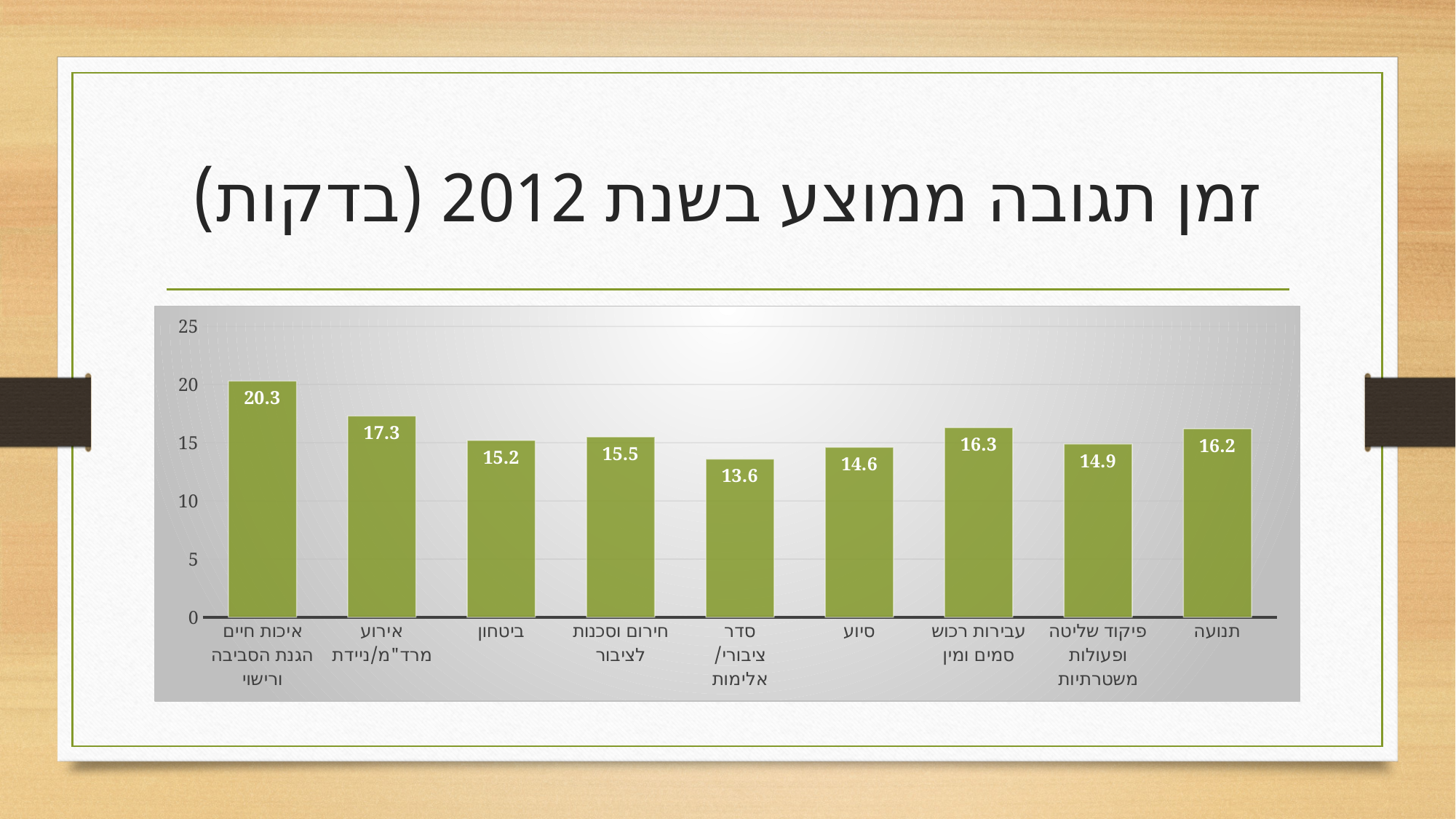
Is the value for פיקוד שליטה ופעולות משטרתיות greater or less than 15? less How many categories are shown in the chart? 9 What is the value for ביטחון? 15.2 What is the difference between the values for איכות חיים הגנת הסביבה ורישוי and סדר ציבורי/אלימות? 6.7 What is the difference between the values for עבירות רכוש סמים ומין and סיוע? 1.7 Which category has the lowest value? סדר ציבורי/אלימות Which is larger, the value for אירוע מרד"מ/ניידת or the value for חירום וסכנות לציבור? אירוע מרד"מ/ניידת What is the value for תנועה? 16.2 What is the title of the chart on the slide? זמן תגובה ממוצע בשנת 2012 (בדקות) What is the value for סיוע? 14.6 Which category has the highest value? איכות חיים הגנת הסביבה ורישוי What kind of chart is shown on the slide? bar chart